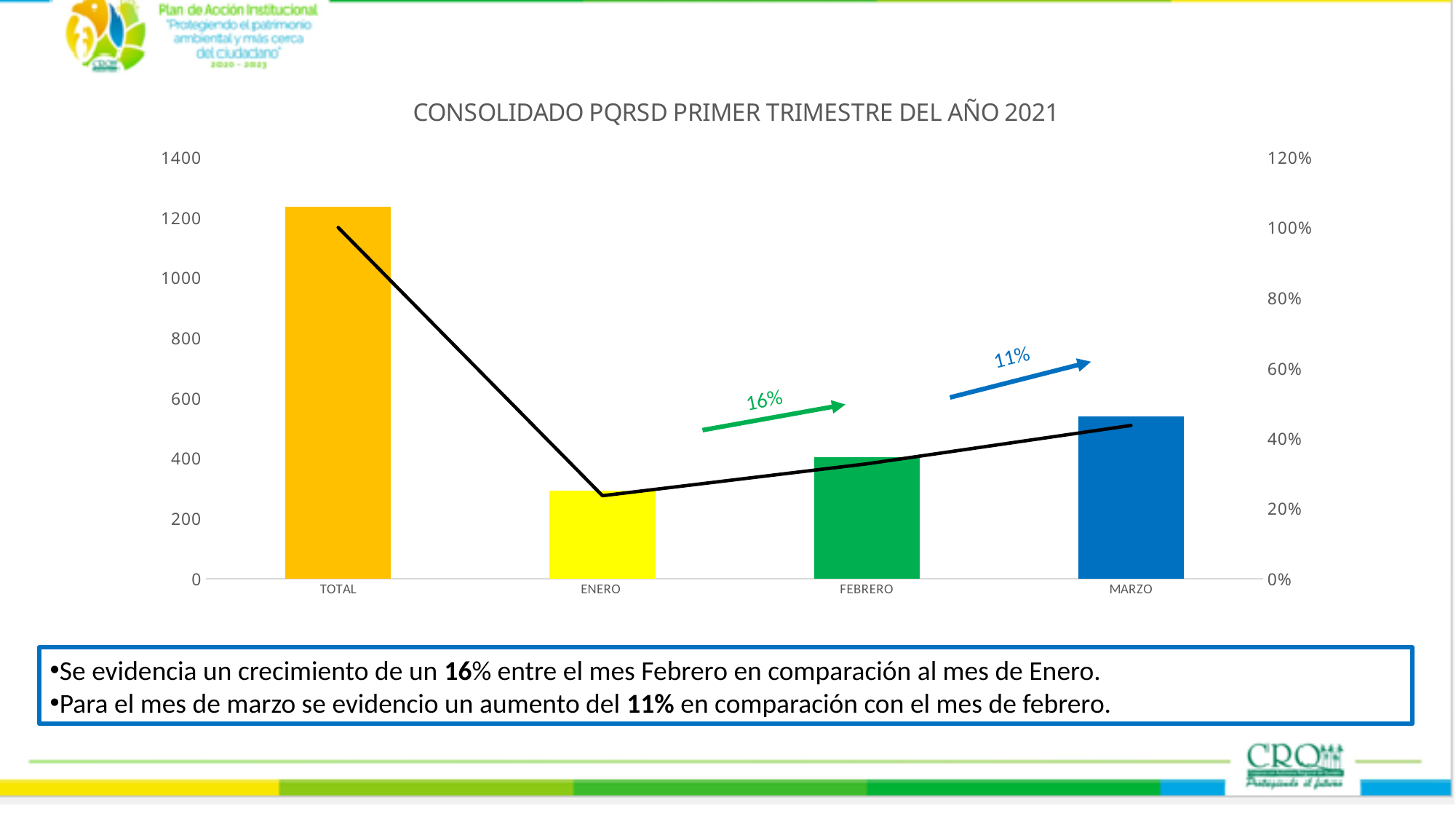
What percentage growth is annotated between ENERO and FEBRERO? 16% Do the bar values rise or fall from ENERO to MARZO? rise Which category has the shortest bar? ENERO Which category has the tallest bar? TOTAL Which bar is taller, FEBRERO or MARZO? MARZO What kind of chart is shown on the slide? Bar chart with a line overlay Is the value for MARZO greater or less than 400? greater How many categories are shown on the x axis of the chart? 4 Is the value for ENERO greater or less than 400? less What percentage increase is annotated between FEBRERO and MARZO? 11% Is the value for TOTAL greater or less than 1000? greater What is the title of the chart? CONSOLIDADO PQRSD PRIMER TRIMESTRE DEL AÑO 2021